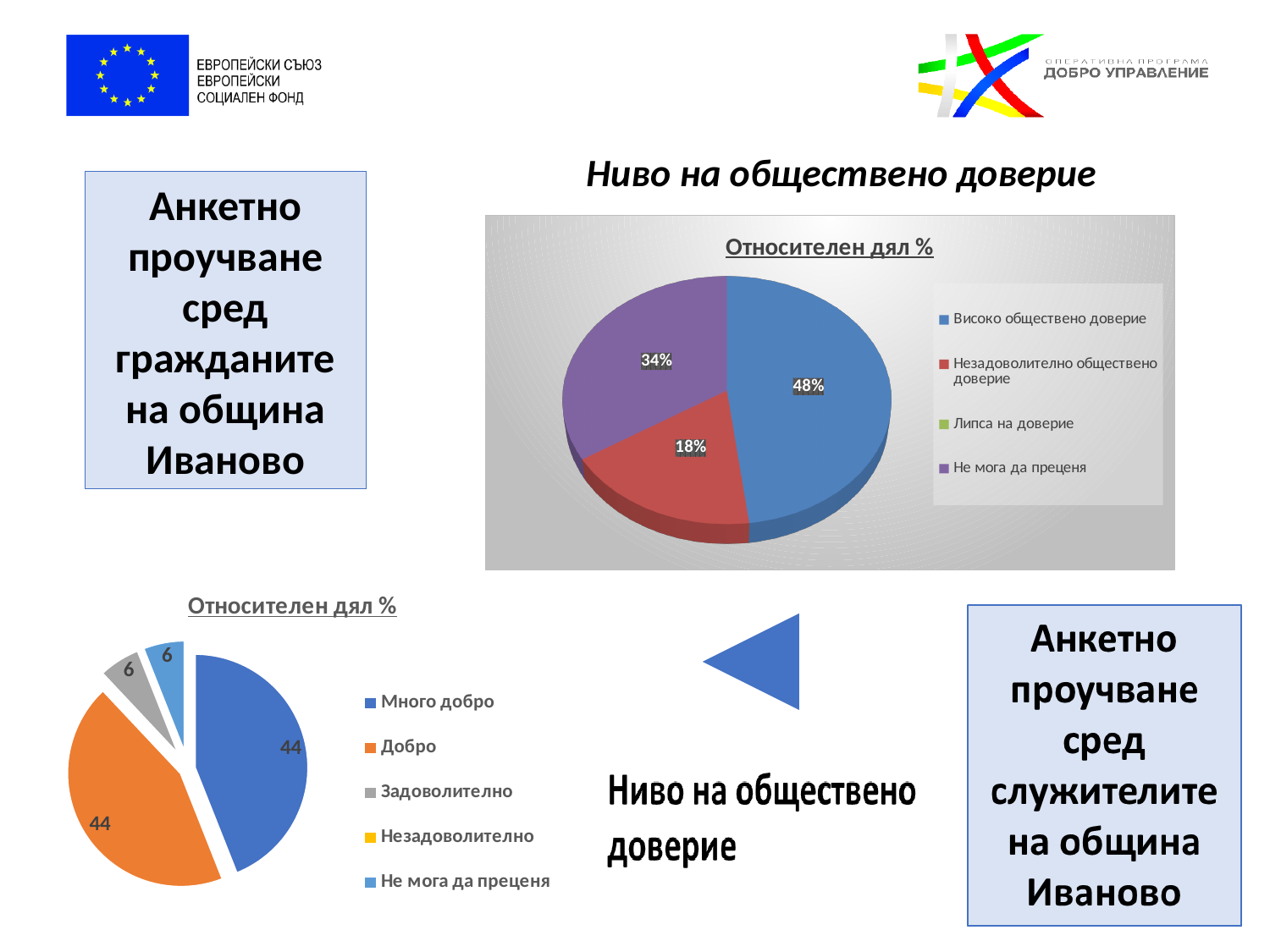
In the top-right pie chart, what is the value for Високо обществено доверие? 48% In the bottom-left pie chart, what colour is the Добро slice? Orange In the top-right pie chart, which category has the largest slice? Високо обществено доверие In the top-right pie chart, what is the value for Незадоволително обществено доверие? 18% In the top-right pie chart, what is the difference between Високо обществено доверие and Незадоволително обществено доверие? 30% In the top-right pie chart, which is larger: Не мога да преценя or Незадоволително обществено доверие? Не мога да преценя In the bottom-left pie chart, what is the value for Добро? 44 In the bottom-left pie chart, what is the value for Задоволително? 6 In the bottom-left pie chart, which is larger: Много добро or Не мога да преценя? Много добро What kind of chart is the bottom-left chart? Pie chart How many entries does the legend of the top-right chart list? 4 In the top-right pie chart, what is the value for Не мога да преценя? 34%